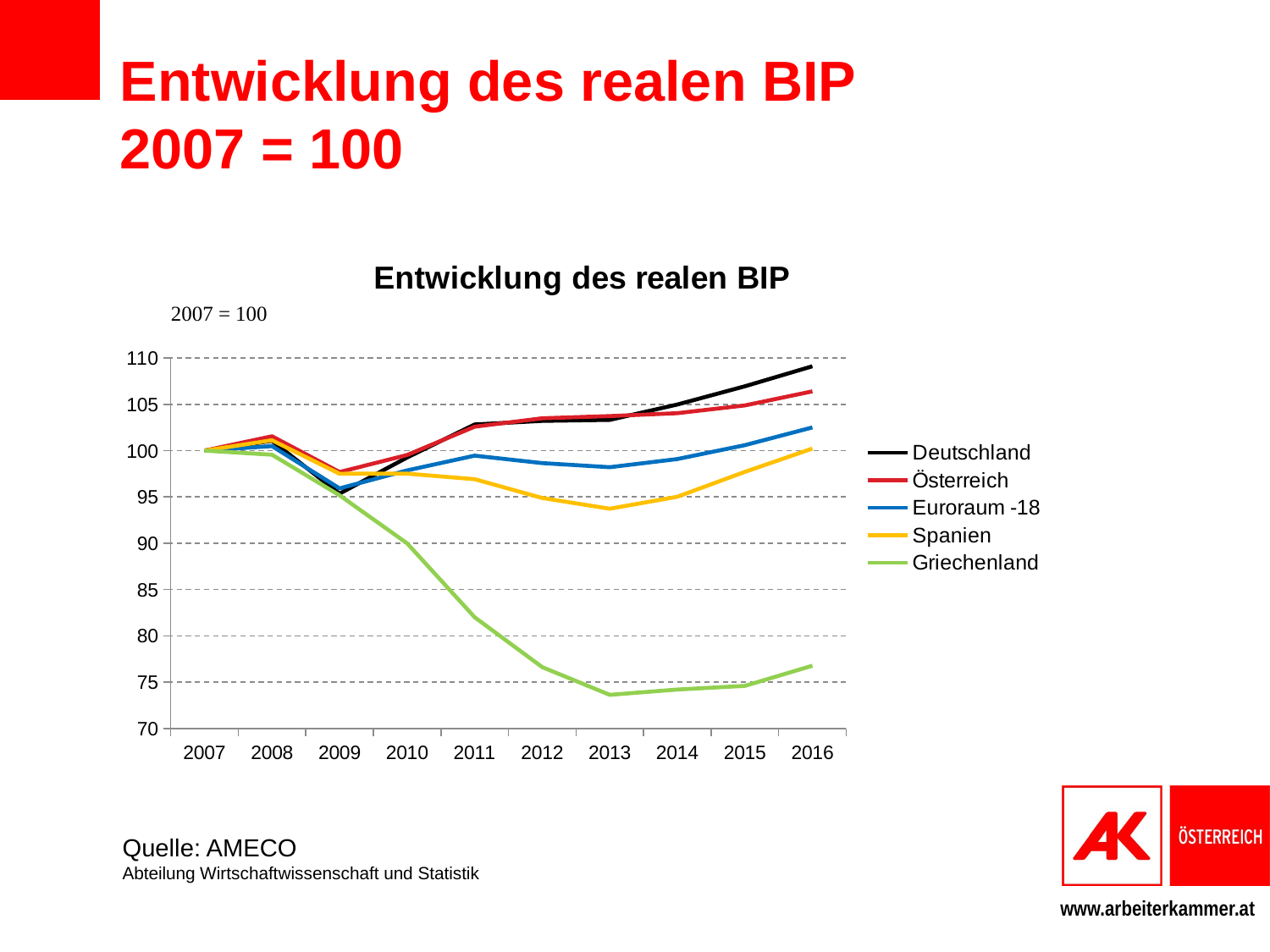
Is the value for Spanien in 2013 greater or less than 95? less Is the value for Deutschland in 2016 greater or less than 105? greater Which country has the lowest value in 2016? Griechenland Which is larger in 2016, the value for Euroraum -18 or the value for Spanien? Euroraum -18 What colour is the line for Griechenland? green What kind of chart is shown on the slide? line chart Is the value for Griechenland in 2013 greater or less than 75? less Which country has the highest value in 2016? Deutschland Does the value for Griechenland rise or fall from 2008 to 2013? fall What is the value for Deutschland in 2007? 100 How many series does the legend list? 5 How many years are shown on the x axis? 10